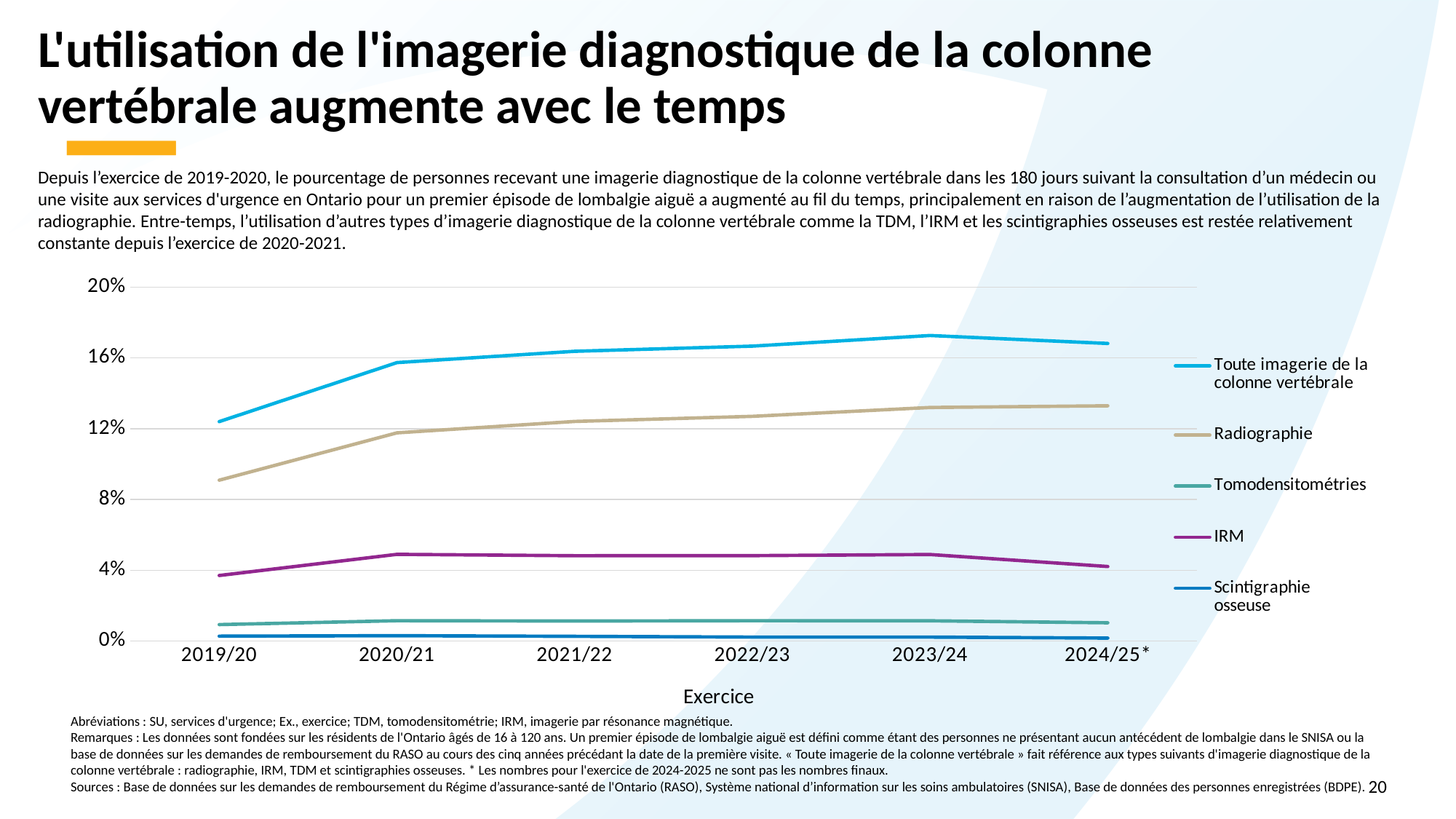
In 2022/23, which is larger: the value for Radiographie or the value for IRM? Radiographie How many series does the legend list? 5 Is the value for Radiographie in 2019/20 greater or less than 12%? less Which series has the lowest values across all years? Scintigraphie osseuse In which fiscal year is the Toute imagerie de la colonne vertébrale value lowest? 2019/20 In which fiscal year does the Toute imagerie de la colonne vertébrale line reach its highest point? 2023/24 Which series has the highest values across all years? Toute imagerie de la colonne vertébrale Is the value for Toute imagerie de la colonne vertébrale in 2023/24 greater or less than 16%? greater How many fiscal years are plotted along the x axis? 6 Does the Radiographie line rise or fall from 2019/20 to 2024/25*? rise What kind of chart is shown on the slide? line chart Is the value for IRM in 2020/21 greater or less than 4%? greater